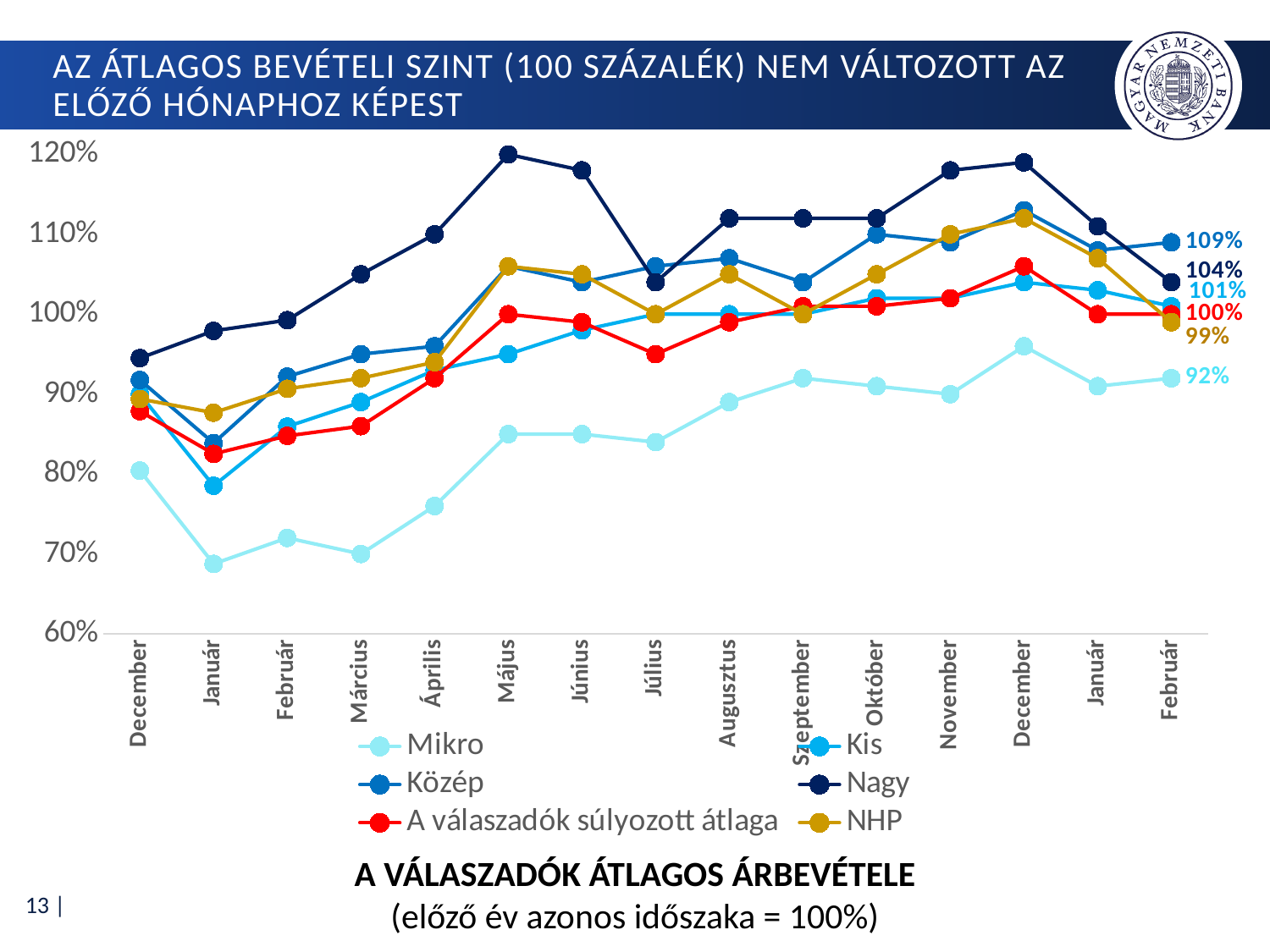
What is the difference between the Közép and Mikro values in the final Február? 17 percentage points How many months are shown along the x axis? 15 Is the value for Mikro in Január (the first one) greater or less than 70%? less How many series does the legend list? 6 Which series is drawn in red? A válaszadók súlyozott átlaga Which series has the lowest value in the final Február? Mikro Which series has the highest value in the final Február? Közép What is the value for Közép in the final Február? 109% What is the value for Nagy in the final Február? 104% What is the value for NHP in the final Február? 99% What type of chart is shown on the slide? line chart What is the value for Mikro in the final Február? 92%